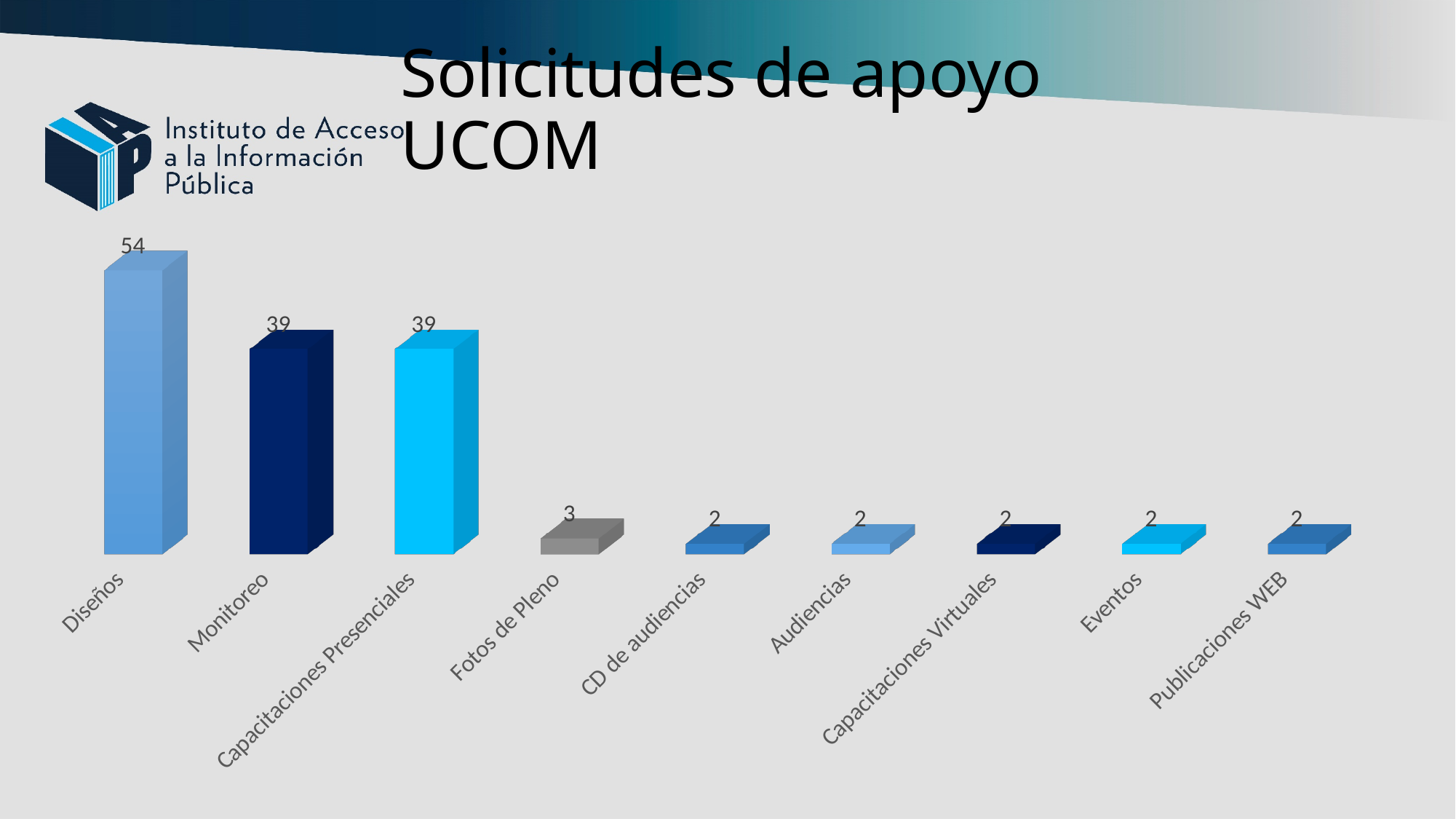
What is the value for Diseños? 54 What is the difference between the values for Diseños and Monitoreo? 15 What kind of chart is shown on the slide? bar chart Which category has the highest value? Diseños How many categories have a value of 2? 5 How many categories are shown in the chart? 9 What is the value for Fotos de Pleno? 3 What is the value for Monitoreo? 39 Which is larger, the value for Fotos de Pleno or the value for Eventos? Fotos de Pleno What is the difference between the values for Capacitaciones Presenciales and Fotos de Pleno? 36 What is the title of the slide? Solicitudes de apoyo UCOM What is the value for Publicaciones WEB? 2